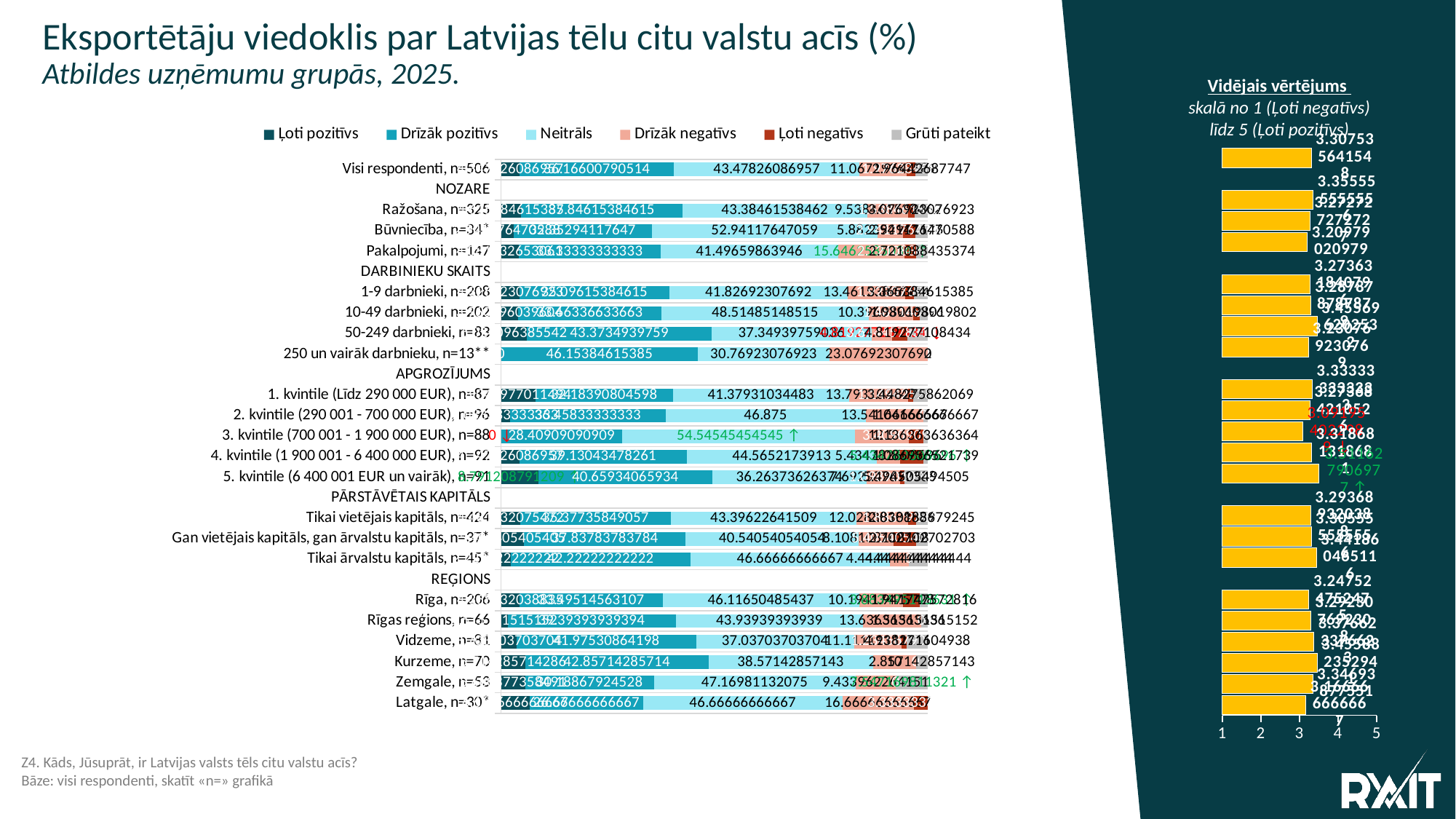
In the main chart, what is the Neitrāls value for Visi respondenti, n=506? 43.47826086957 In the main chart, what is the Neitrāls value for Būvniecība, n=34*? 52.94117647059 In the right-hand chart (Vidējais vērtējums), is the value for Visi respondenti greater or less than 3? greater In the main chart, which has the larger Neitrāls value: Būvniecība, n=34* or Ražošana, n=325? Būvniecība, n=34* What kind of chart is the main chart on the left of the slide? bar chart What is the first series listed in the legend of the main chart? Ļoti pozitīvs In the main chart, which group has the lowest Neitrāls value? 250 un vairāk darbnieku, n=13** In the main chart, which group has the highest Neitrāls value? 3. kvintile (700 001 - 1 900 000 EUR), n=88 In the main chart, what is the Drīzāk pozitīvs value for 250 un vairāk darbnieku, n=13**? 46.15384615385 In the main chart, what is the Neitrāls value for Zemgale, n=53? 47.16981132075 How many series does the legend of the main chart list? 6 In the main chart, what is the Neitrāls value for 2. kvintile (290 001 - 700 000 EUR), n=96? 46.875